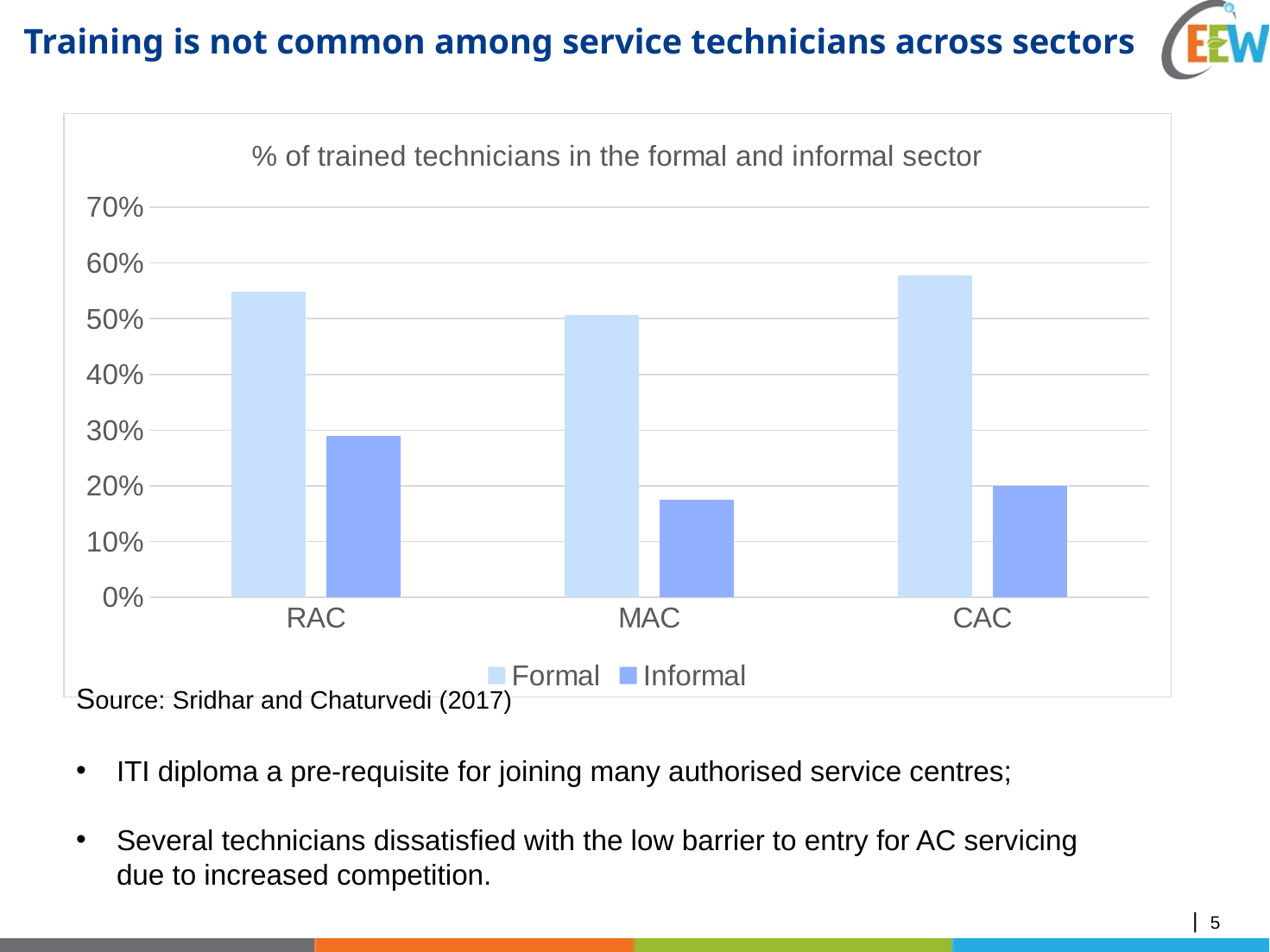
How many categories are shown on the x axis of the chart? 3 For RAC, which is larger, the Formal value or the Informal value? Formal Is the Formal value for CAC greater or less than 50%? greater Is the Informal value for MAC greater or less than 20%? less What kind of chart is shown on the slide? bar chart Which category has the highest Informal value? RAC Is the Informal value for CAC greater or less than 30%? less What is the title of the chart? % of trained technicians in the formal and informal sector How many series does the chart's legend list? 2 Which category has the lowest Formal value? MAC Which series is shown in the darker blue bars? Informal